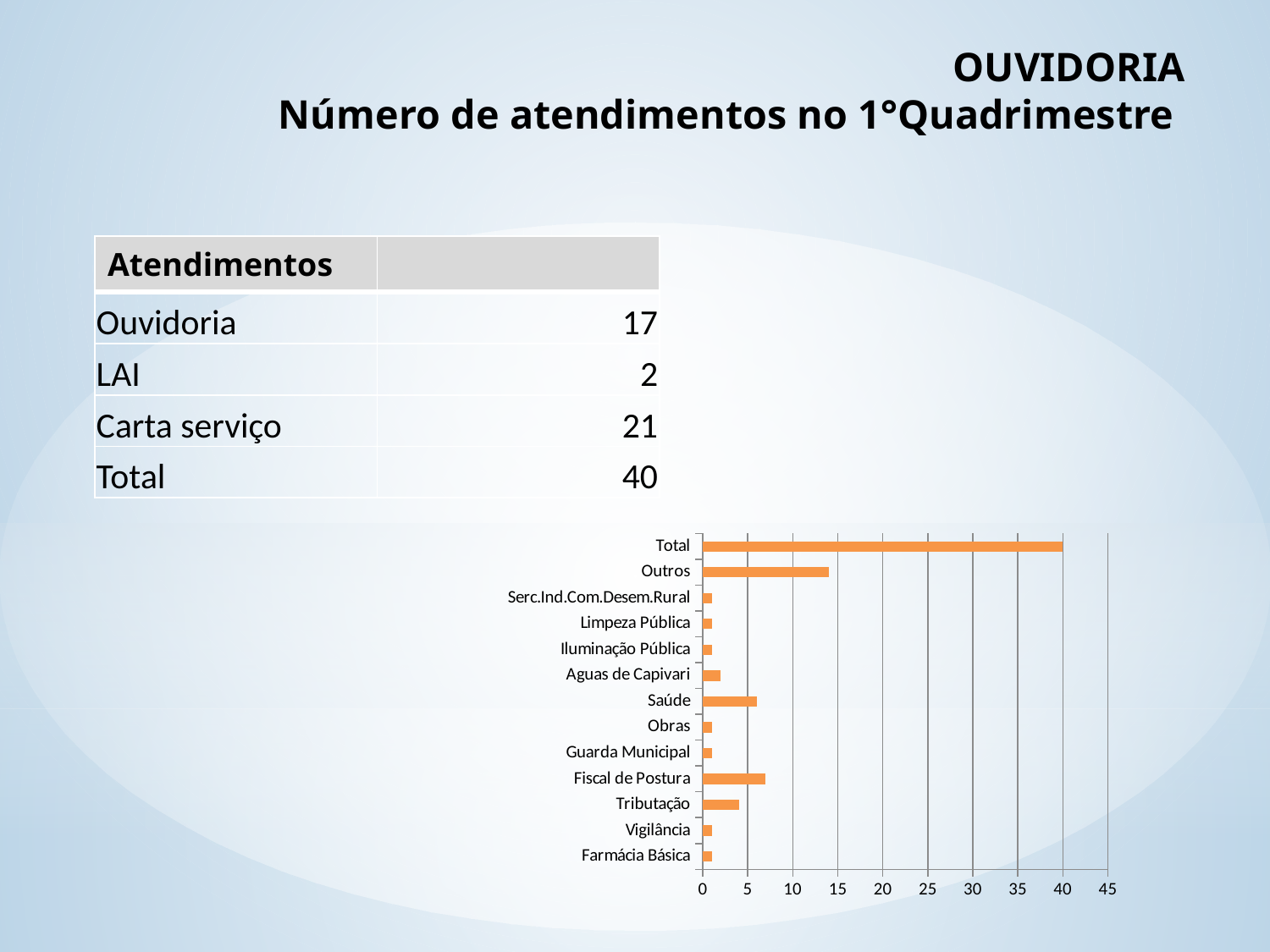
What is the value of the Total bar in the chart? 40 Is the value for Outros greater or less than 10? greater Which is larger, the value for Outros or the value for Saúde? Outros Which is larger, the value for Fiscal de Postura or the value for Tributação? Fiscal de Postura What colour are the bars in the chart? orange Which category has the longest bar in the chart? Total How many categories are plotted in the bar chart? 13 Is the value for Saúde greater or less than 5? greater Is the value for Tributação greater or less than 5? less What kind of chart is shown on the slide? bar chart What is the highest value shown on the horizontal axis of the chart? 45